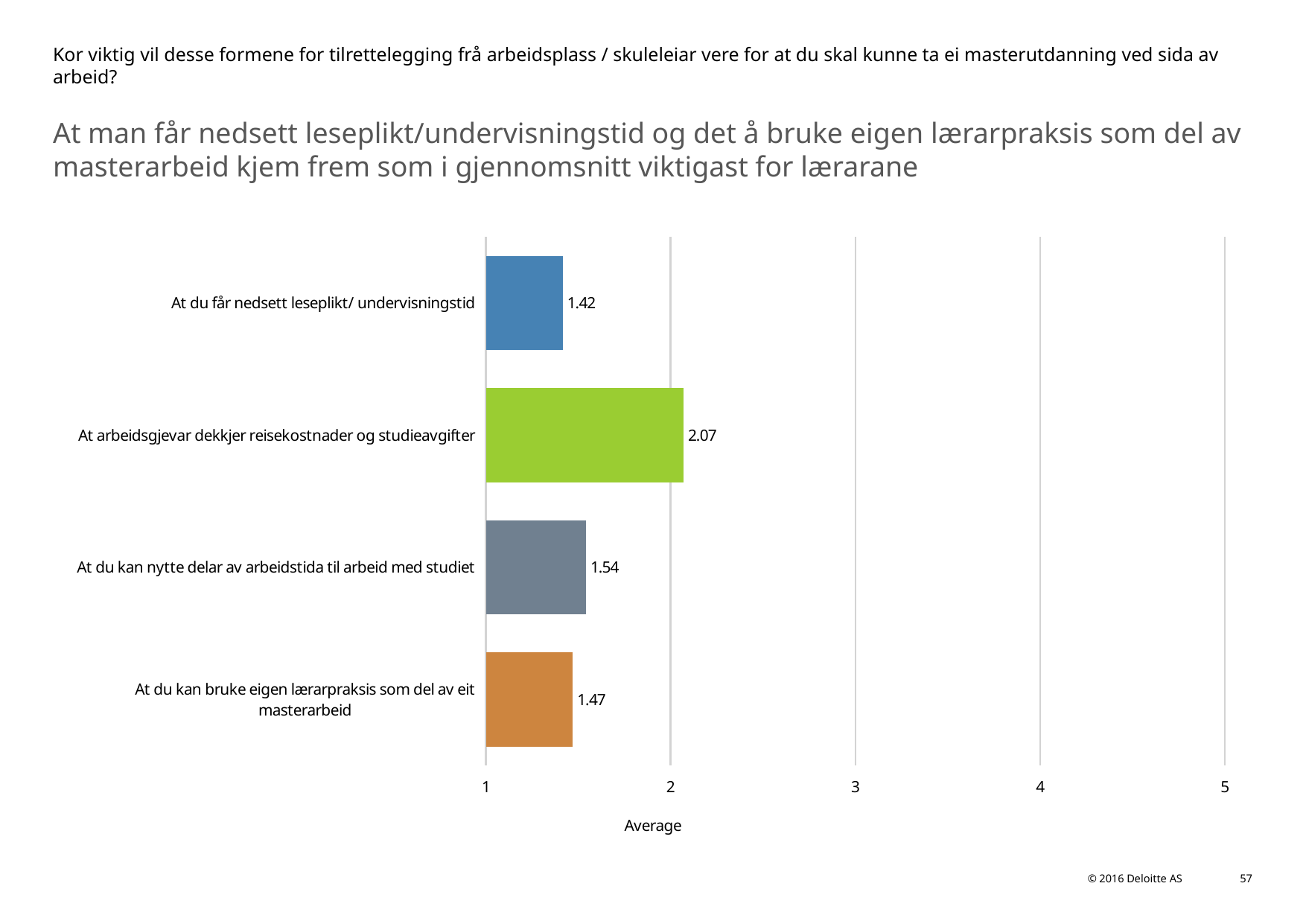
What is the average value for "At du kan nytte delar av arbeidstida til arbeid med studiet"? 1.54 Which category has the highest average value? At arbeidsgjevar dekkjer reisekostnader og studieavgifter What is the average value for "At du kan bruke eigen lærarpraksis som del av eit masterarbeid"? 1.47 What is the label of the horizontal axis? Average Which category has the lowest average value? At du får nedsett leseplikt/ undervisningstid Which has a higher average: "At du kan nytte delar av arbeidstida til arbeid med studiet" or "At du kan bruke eigen lærarpraksis som del av eit masterarbeid"? At du kan nytte delar av arbeidstida til arbeid med studiet What kind of chart is shown on the slide? Bar chart What is the average value for "At du får nedsett leseplikt/ undervisningstid"? 1.42 How many categories are shown in the chart? 4 What is the average value for "At arbeidsgjevar dekkjer reisekostnader og studieavgifter"? 2.07 Is the value for "At arbeidsgjevar dekkjer reisekostnader og studieavgifter" greater or less than 2? greater What is the difference between the average for "At arbeidsgjevar dekkjer reisekostnader og studieavgifter" and "At du får nedsett leseplikt/ undervisningstid"? 0.65